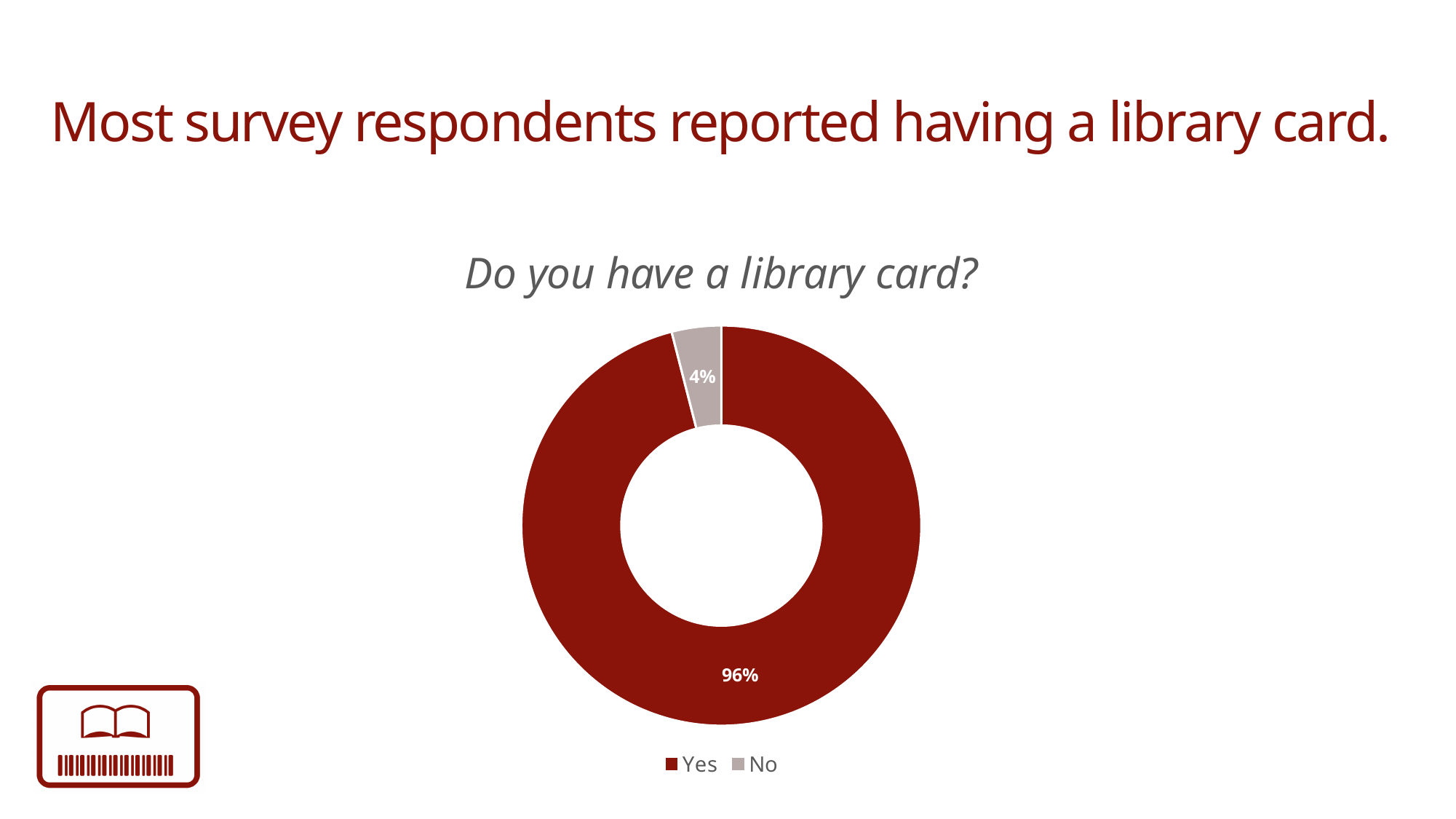
Which response has the smallest share of the chart? No What is the title of the chart? Do you have a library card? Which response has the largest share of the chart? Yes What kind of chart is shown on the slide? Doughnut chart How many categories are shown in the chart? 2 What share of the chart does the Yes slice represent? 96% What is the difference in percentage points between the Yes and No responses? 92 What colour is the No slice in the chart? Grey What percentage of respondents answered Yes to having a library card? 96% How many entries does the legend list? 2 Which response is larger, Yes or No? Yes What percentage of respondents answered No to having a library card? 4%